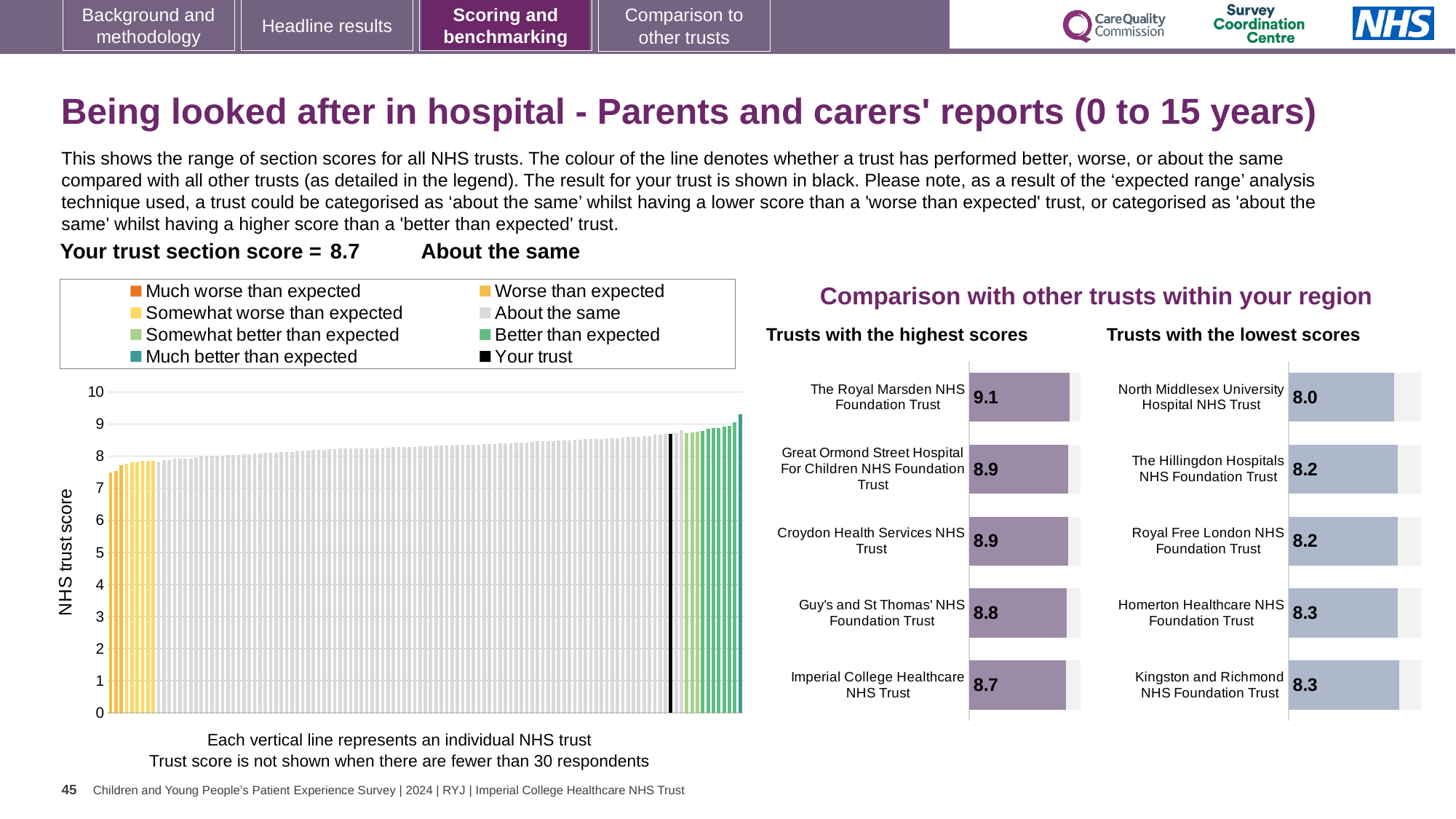
In the 'Trusts with the highest scores' chart, what is the difference between the scores of The Royal Marsden NHS Foundation Trust and Imperial College Healthcare NHS Trust? 0.4 In the 'Trusts with the highest scores' chart, what is the score for The Royal Marsden NHS Foundation Trust? 9.1 In the 'Trusts with the lowest scores' chart, what is the difference between the scores of Homerton Healthcare NHS Foundation Trust and North Middlesex University Hospital NHS Trust? 0.3 In the 'Trusts with the highest scores' chart, which has the larger score: Guy's and St Thomas' NHS Foundation Trust or Imperial College Healthcare NHS Trust? Guy's and St Thomas' NHS Foundation Trust In the 'Trusts with the lowest scores' chart, what is the score for North Middlesex University Hospital NHS Trust? 8.0 What kind of chart is the main chart on the left with the 'NHS trust score' axis? Bar chart How many entries does the legend of the main 'NHS trust score' chart list? 8 In the 'Trusts with the highest scores' chart, which trust has the highest score? The Royal Marsden NHS Foundation Trust What is the y-axis label of the main chart on the left? NHS trust score How many trusts are shown in the 'Trusts with the lowest scores' chart? 5 In the main 'NHS trust score' chart, is the value for the black 'Your trust' bar greater or less than 8? greater In the 'Trusts with the lowest scores' chart, which trust has the lowest score? North Middlesex University Hospital NHS Trust